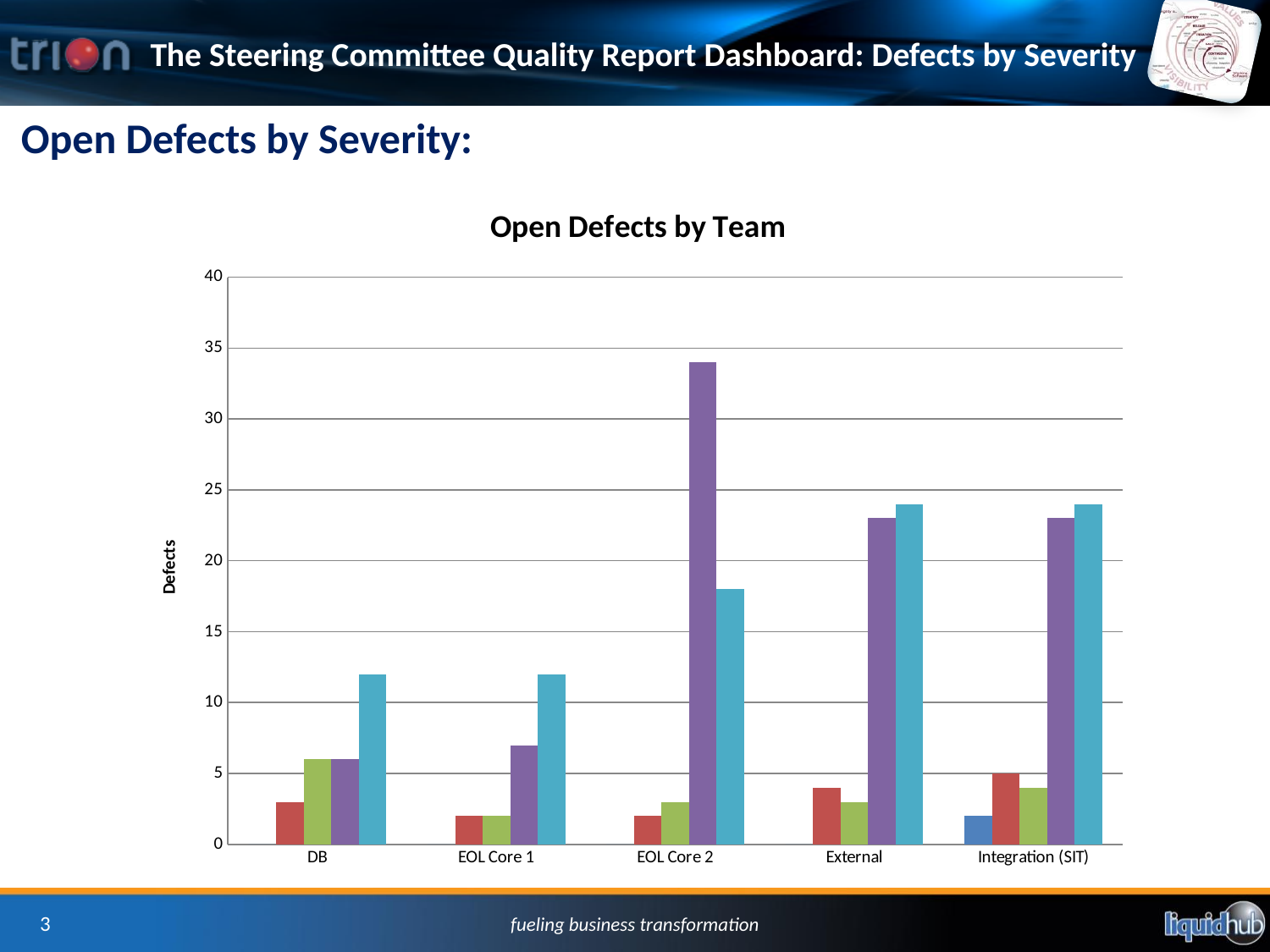
How many teams (categories) are shown on the x axis of the chart? 5 Is the value of the red bar for External greater or less than 5? less What kind of chart is shown on the slide? bar chart Is the value of the green bar for EOL Core 1 greater or less than 5? less For EOL Core 2, which is larger: the purple bar or the light blue bar? the purple bar What is the title of the chart? Open Defects by Team Is the value of the light blue bar for EOL Core 2 greater or less than 15? greater What is the label on the vertical axis of the chart? Defects Which team has the tallest bar in the chart? EOL Core 2